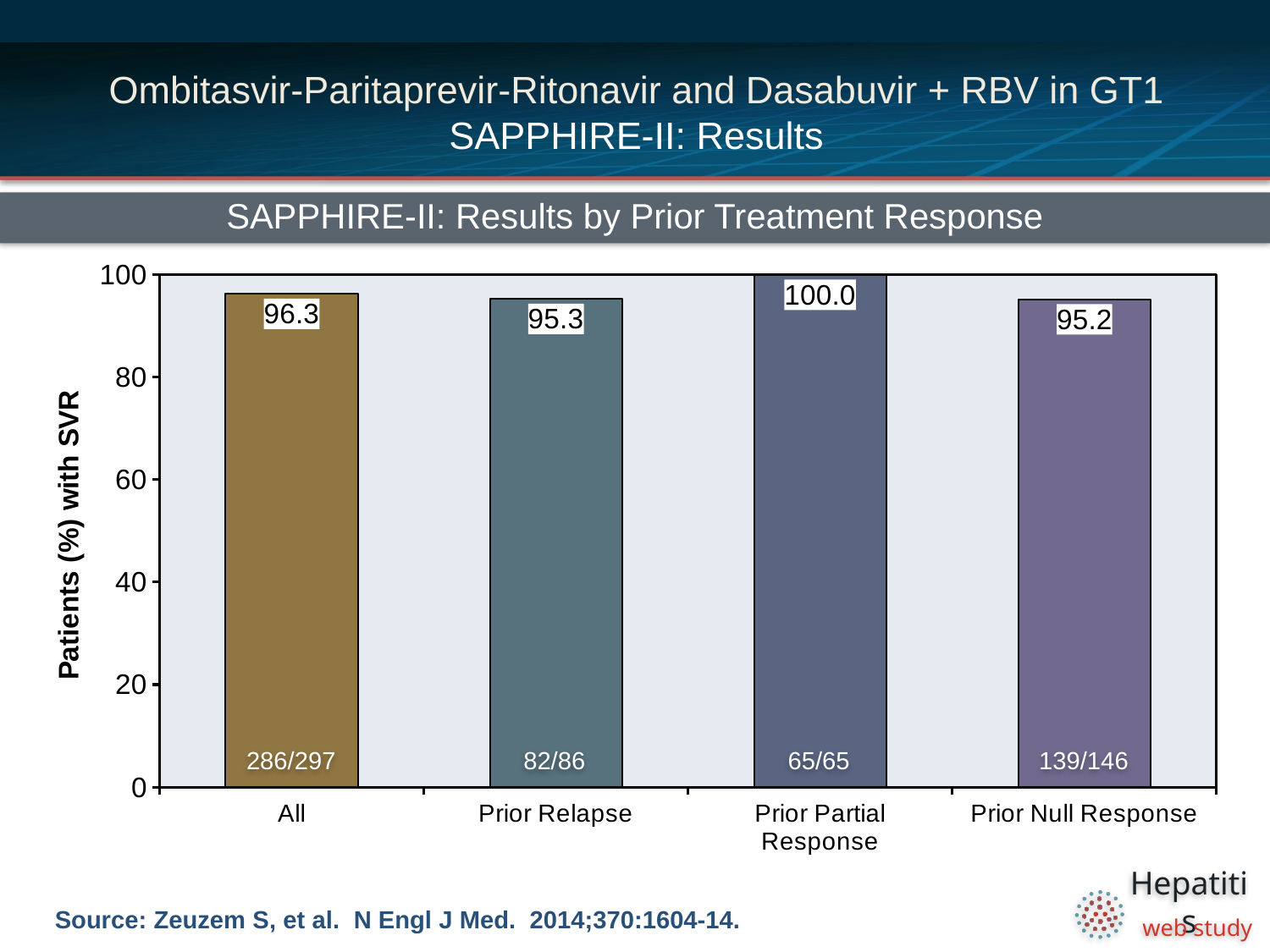
Is the value for Prior Relapse greater or less than 80? greater What fraction of patients is shown inside the Prior Null Response bar? 139/146 Which category has the highest value? Prior Partial Response What is the value for Prior Null Response? 95.2 How many categories are shown on the x axis? 4 What is the value for Prior Relapse? 95.3 What is the value for All? 96.3 What kind of chart is shown on the slide? bar chart What is the value for Prior Partial Response? 100.0 Which is larger, the value for Prior Partial Response or the value for Prior Relapse? Prior Partial Response What is the difference between the values for Prior Partial Response and All? 3.7 What fraction of patients is shown inside the All bar? 286/297